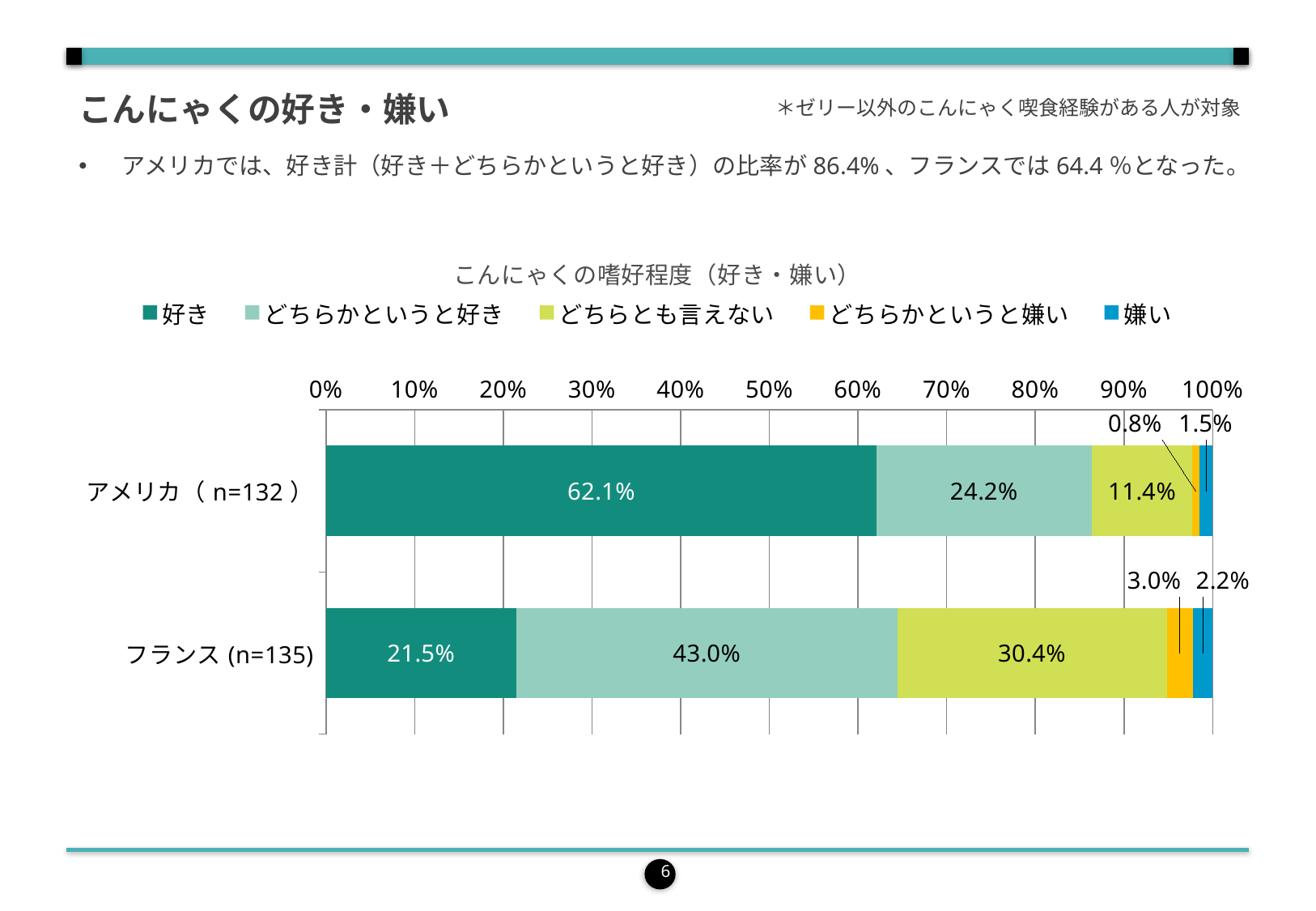
What is the value of 好き for アメリカ (n=132)? 62.1% What type of chart is shown on the slide? Stacked bar chart What is the difference between the 好き values for アメリカ and フランス? 40.6% What is the title of the chart? こんにゃくの嗜好程度（好き・嫌い） What is the value of どちらかというと好き for フランス (n=135)? 43.0% What is the value of どちらかというと嫌い for フランス (n=135)? 3.0% How many categories (countries) are plotted on the chart? 2 What is the combined total of 好き and どちらかというと好き for フランス (n=135)? 64.5% What is the value of 嫌い for アメリカ (n=132)? 1.5% How many series does the legend list? 5 What is the value of どちらとも言えない for アメリカ (n=132)? 11.4% Which country has the higher value for 好き? アメリカ (n=132)